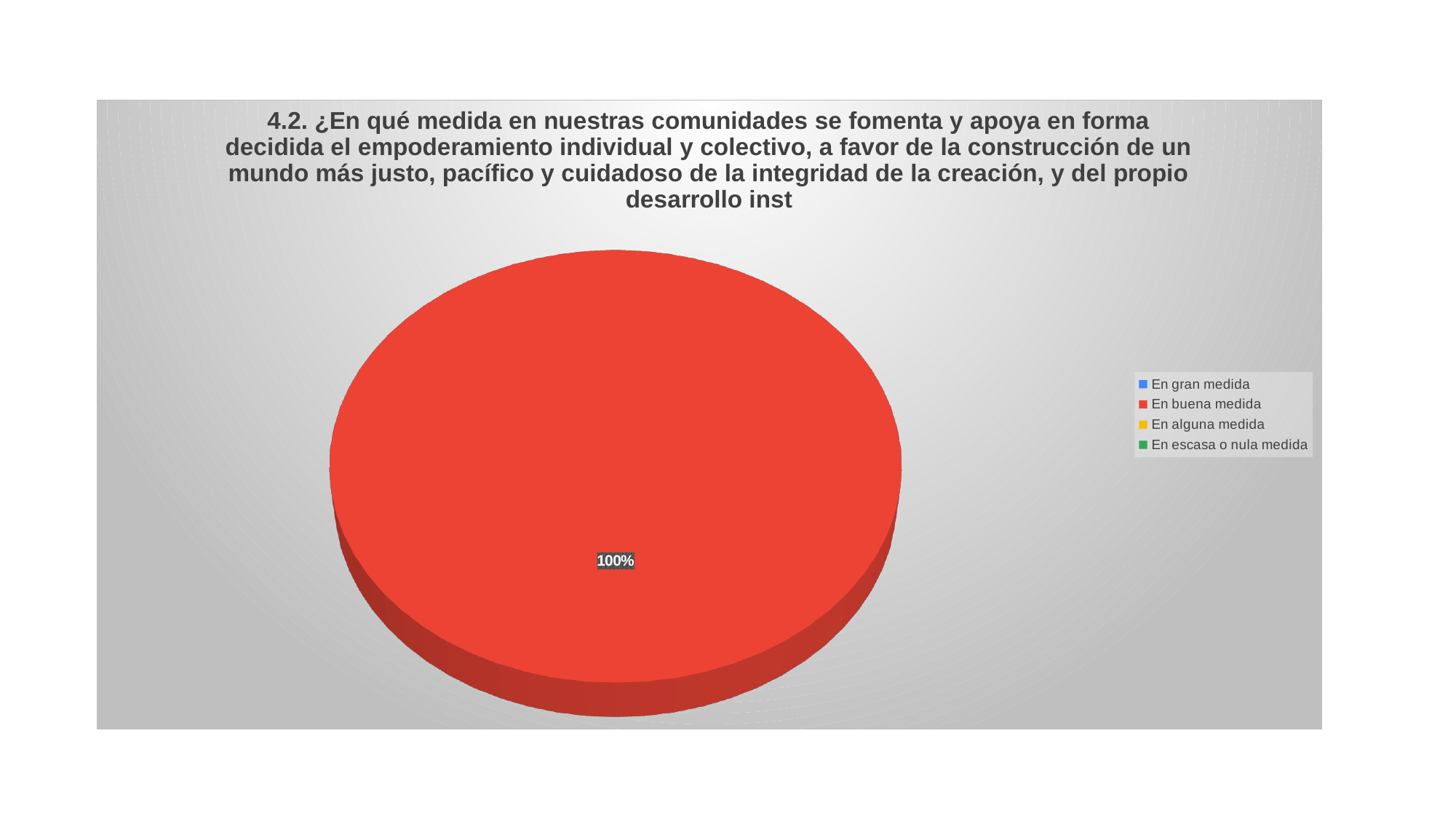
Which legend entry is shown in green? En escasa o nula medida What kind of chart is shown on the slide? pie chart Is the share for "En buena medida" greater or less than 50%? greater Which is larger, the share for "En buena medida" or the share for "En gran medida"? En buena medida What share of the pie does "En buena medida" hold? 100% Which category accounts for the entire pie? En buena medida How many slices are visible in the pie? 1 How many entries does the legend list? 4 What colour is the slice labelled 100%? red